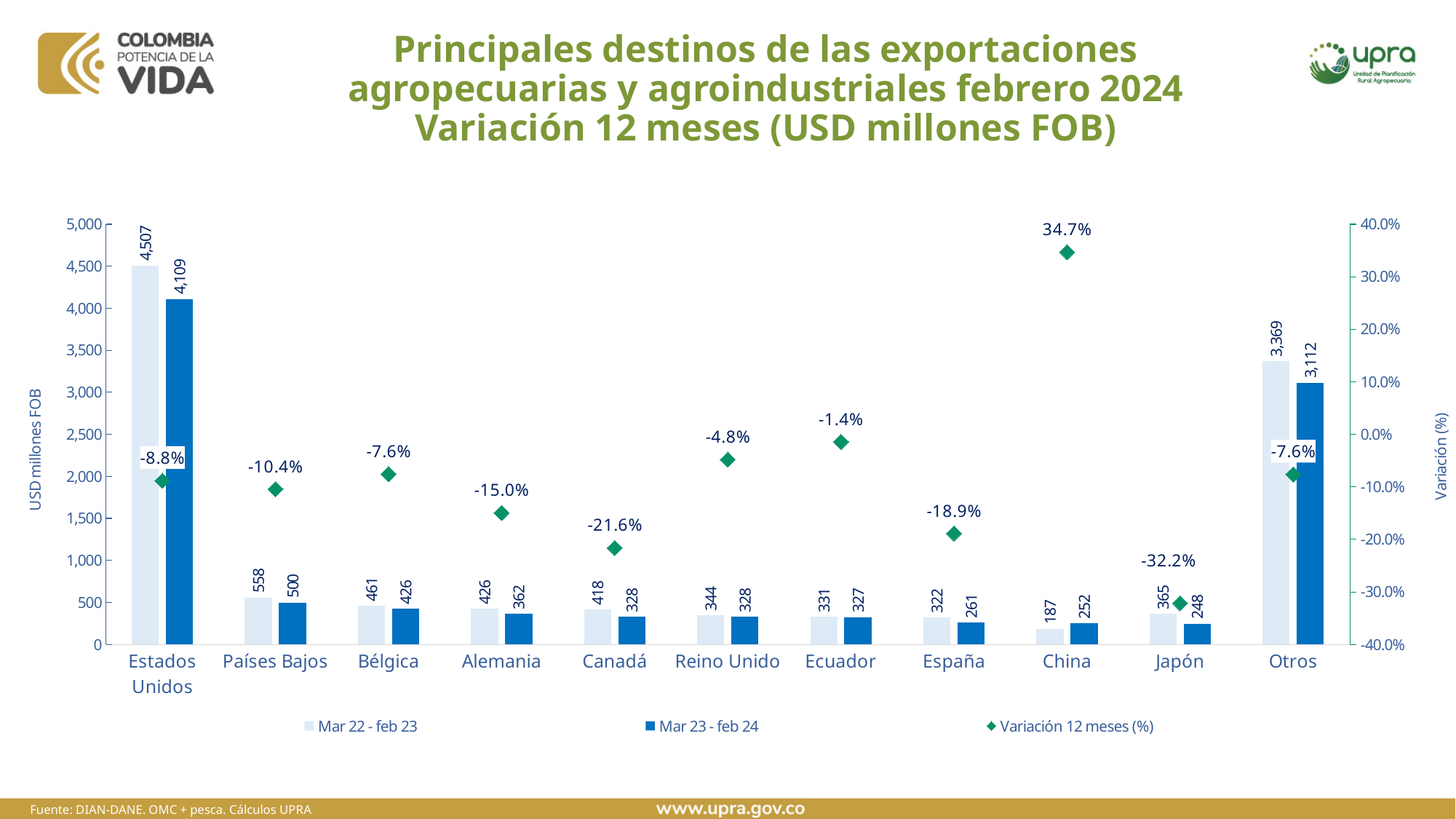
What is the label of the left vertical axis? USD millones FOB Is the Mar 23 - feb 24 value for Otros greater or less than 3,000? greater How many categories are shown on the x axis? 11 Which category has the lowest Variación 12 meses (%) value? Japón What is the value for Países Bajos in the Mar 22 - feb 23 series? 558 What is the Variación 12 meses (%) value for China? 34.7% Which is larger for China: the Mar 22 - feb 23 value or the Mar 23 - feb 24 value? Mar 23 - feb 24 What is the difference between the Mar 22 - feb 23 and Mar 23 - feb 24 values for Estados Unidos? 398 How many series does the legend list? 3 What is the value for Estados Unidos in the Mar 23 - feb 24 series? 4,109 Which category has the highest Mar 23 - feb 24 value? Estados Unidos Which category has the lowest Mar 22 - feb 23 value? China